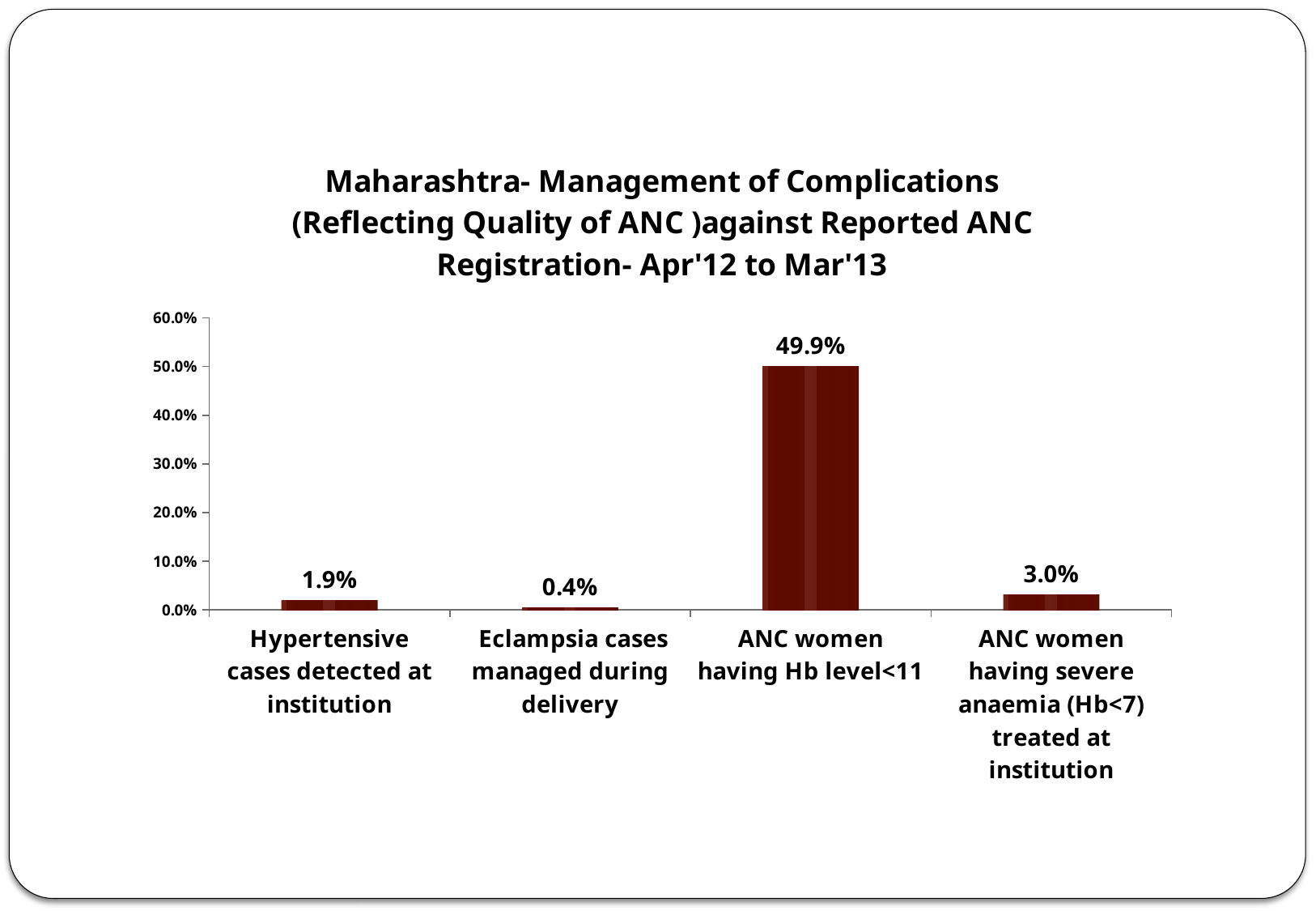
Is the value for ANC women having Hb level<11 greater or less than 40.0%? greater What is the value for Eclampsia cases managed during delivery? 0.4% What kind of chart is shown on the slide? Bar chart Which category has the highest value? ANC women having Hb level<11 Which category has the lowest value? Eclampsia cases managed during delivery What is the value for Hypertensive cases detected at institution? 1.9% What period does the chart title say the data covers? Apr'12 to Mar'13 What is the value for ANC women having severe anaemia (Hb<7) treated at institution? 3.0% How many categories are shown on the chart? 4 What is the difference between the value for ANC women having Hb level<11 and the value for ANC women having severe anaemia (Hb<7) treated at institution? 46.9% What is the value for ANC women having Hb level<11? 49.9% Which is larger: the value for Hypertensive cases detected at institution or the value for ANC women having severe anaemia (Hb<7) treated at institution? ANC women having severe anaemia (Hb<7) treated at institution